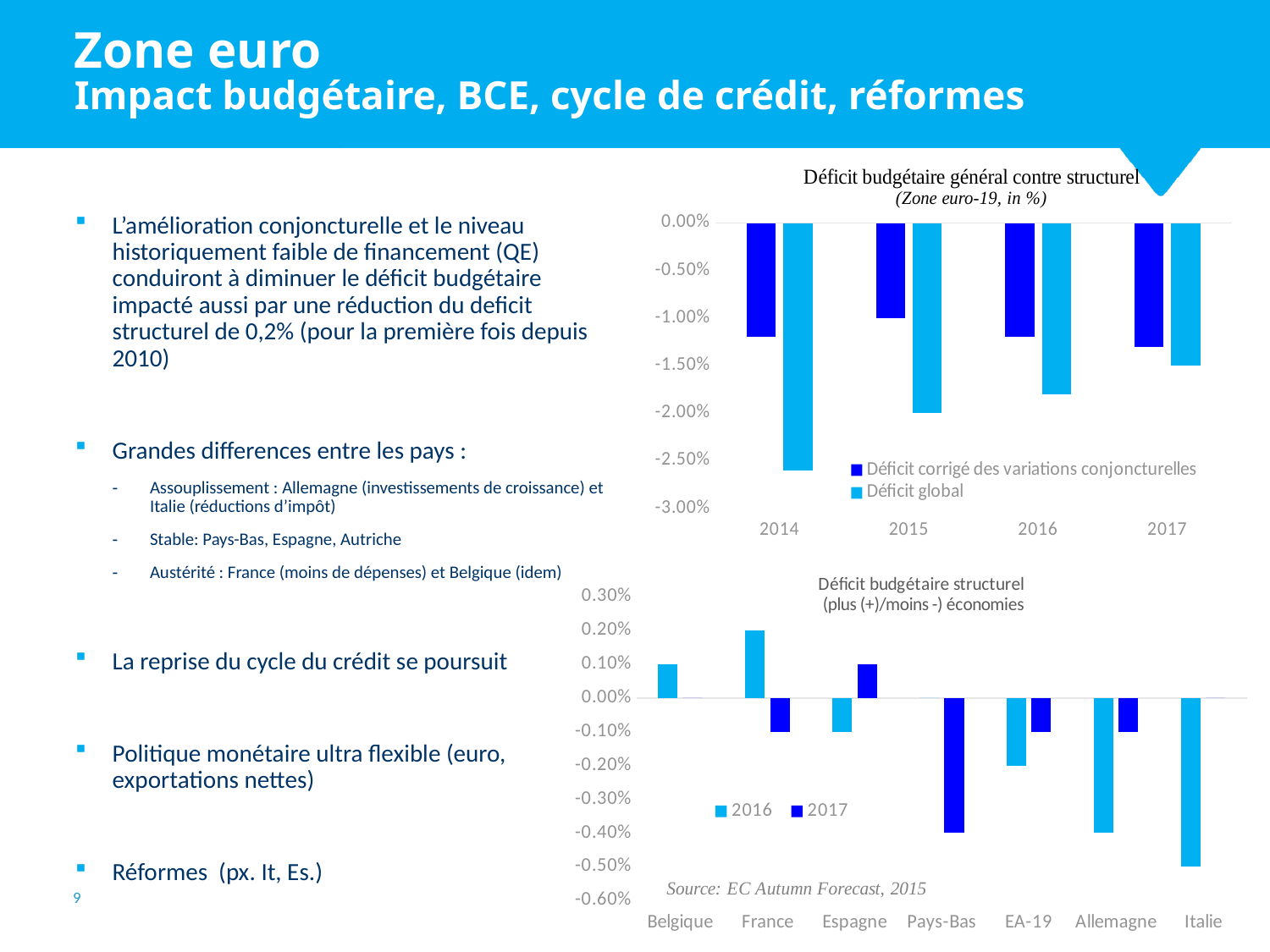
In the top chart 'Déficit budgétaire général contre structurel', how many series does the legend list? 2 In the top chart 'Déficit budgétaire général contre structurel', what are the two legend entries? Déficit corrigé des variations conjoncturelles; Déficit global In the top chart 'Déficit budgétaire général contre structurel', which year has the lowest (most negative) value for 'Déficit global'? 2014 In the top chart 'Déficit budgétaire général contre structurel', how many years are shown on the x axis? 4 In the bottom chart 'Déficit budgétaire structurel', which category has the lowest (most negative) value for 2016? Italie In the bottom chart 'Déficit budgétaire structurel', how many series does the legend list? 2 In the bottom chart 'Déficit budgétaire structurel', which category has the highest value for 2016? France What kind of chart is the top chart titled 'Déficit budgétaire général contre structurel'? bar chart In the top chart 'Déficit budgétaire général contre structurel', is the value of 'Déficit global' for 2014 greater or less than -2.00%? less In the bottom chart 'Déficit budgétaire structurel', is the 2016 value for Allemagne greater or less than -0.30%? less In the bottom chart 'Déficit budgétaire structurel', how many countries or regions are shown on the x axis? 7 In the top chart 'Déficit budgétaire général contre structurel', which series has the larger (less negative) value in 2017? Déficit corrigé des variations conjoncturelles